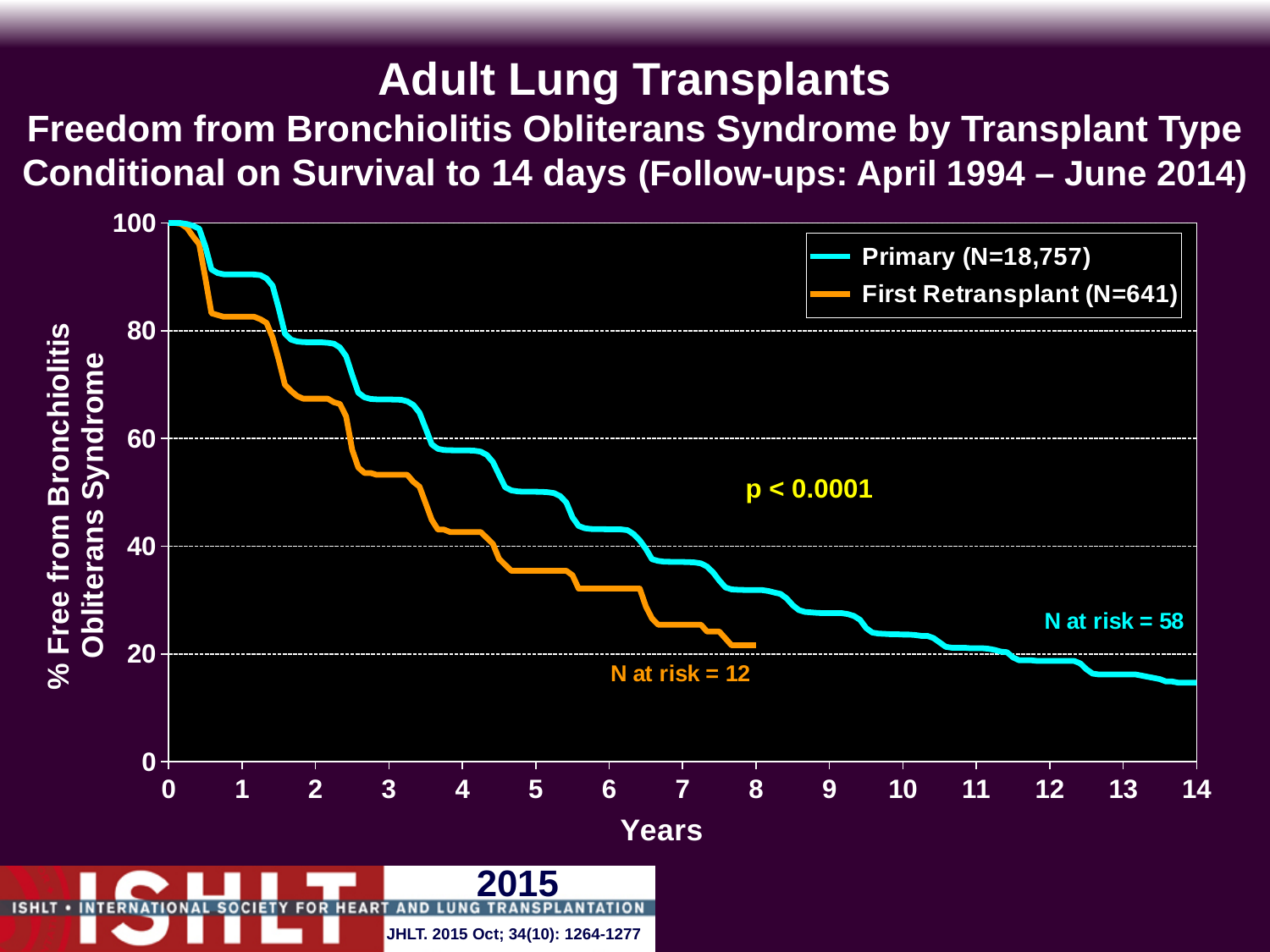
What is the N at risk value printed for the First Retransplant curve? 12 At 3 years, which series has the higher % free from Bronchiolitis Obliterans Syndrome, Primary or First Retransplant? Primary Is the value for the Primary curve at 2 years greater or less than 60? greater Is the value for the First Retransplant curve at 5 years greater or less than 40? less Do the curves rise or fall as years increase? fall What kind of chart is shown on the slide? line chart What is the N for the Primary series shown in the legend? 18,757 What is the N at risk value printed for the Primary curve? 58 What p-value is printed on the chart? p < 0.0001 How many series does the legend list? 2 Is the value for the Primary curve at 14 years greater or less than 20? less What is the N for the First Retransplant series shown in the legend? 641